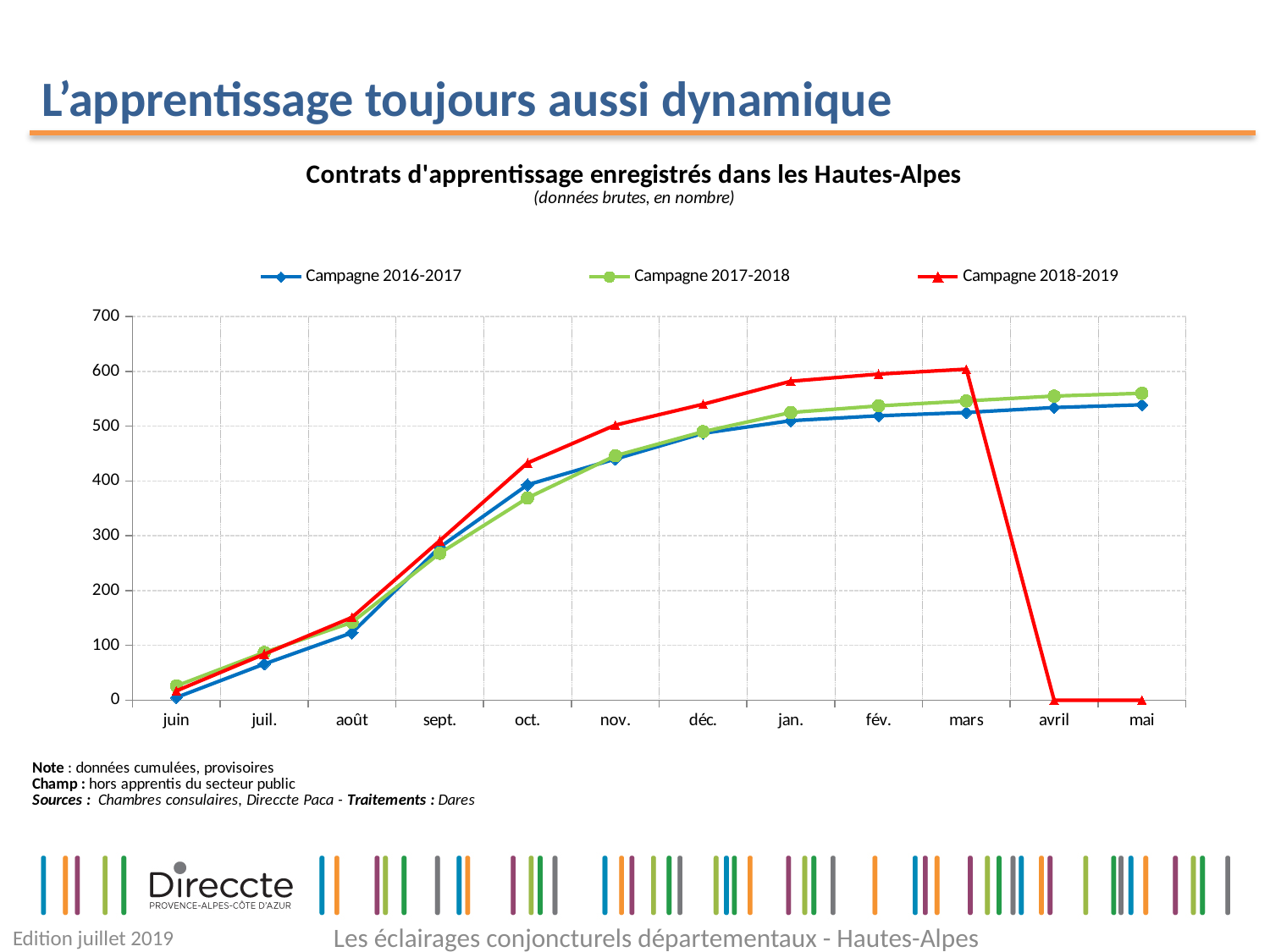
Is the value for Campagne 2017-2018 in oct. greater or less than 400? less Which series has the highest value in jan.? Campagne 2018-2019 Is the value for Campagne 2016-2017 in août greater or less than 200? less How many months are shown along the x axis? 12 What is the title of the chart? Contrats d'apprentissage enregistrés dans les Hautes-Alpes What kind of chart is shown on the slide? line chart How many series does the legend list? 3 Is the value for Campagne 2018-2019 in mars greater or less than 500? greater In oct., which is larger: Campagne 2018-2019 or Campagne 2017-2018? Campagne 2018-2019 Which series is drawn in red with triangle markers? Campagne 2018-2019 Do the values for Campagne 2017-2018 rise or fall from juin to mai? rise In which month is the value for Campagne 2016-2017 lowest? juin